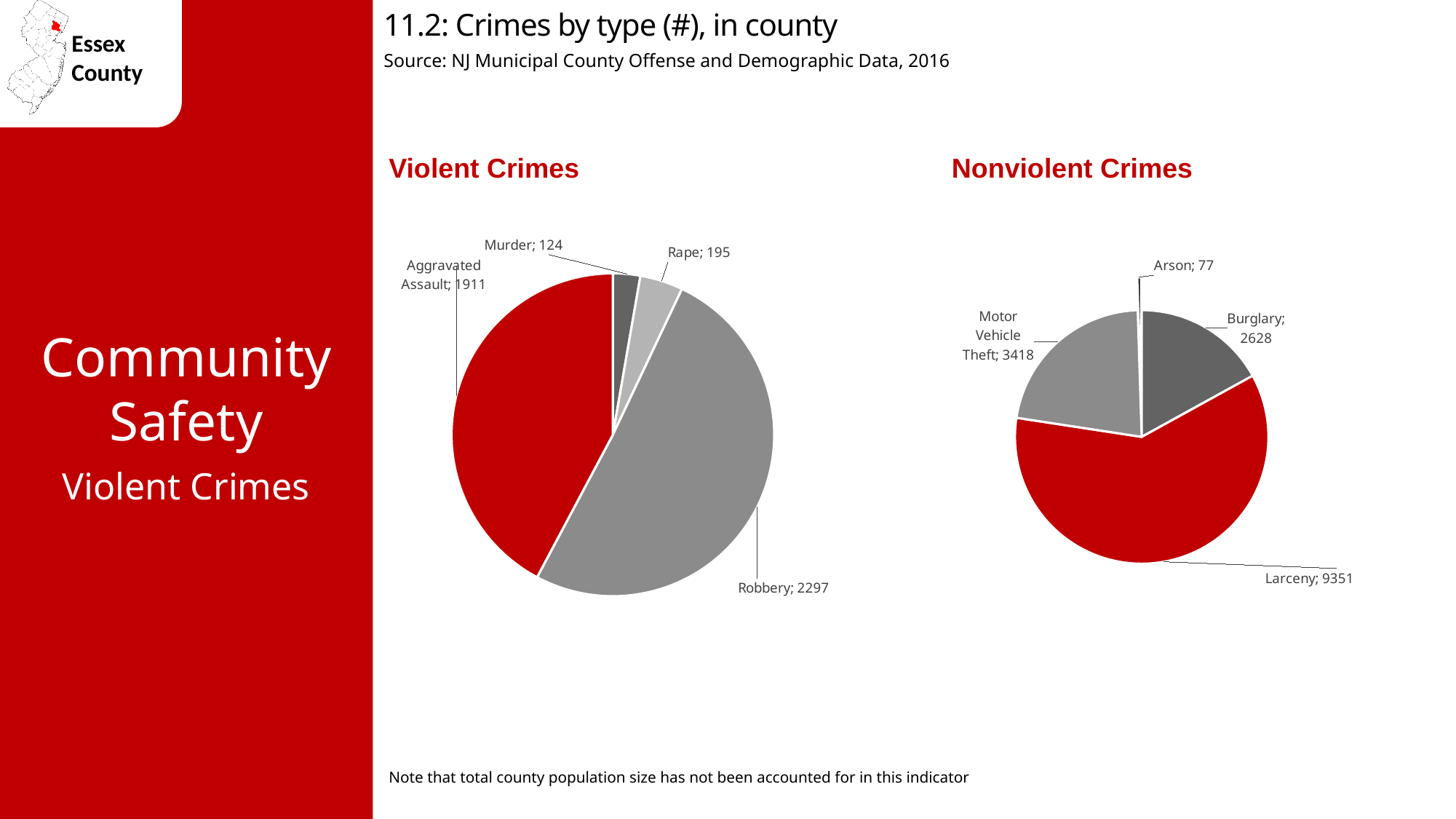
What type of chart is used for Violent Crimes? Pie chart What is the source cited for the charts on this slide? NJ Municipal County Offense and Demographic Data, 2016 In the Nonviolent Crimes pie chart, which crime type has the smallest value? Arson In the Nonviolent Crimes pie chart, which crime type has the largest value? Larceny In the Nonviolent Crimes pie chart, what is the value for Motor Vehicle Theft? 3418 How many crime types are shown in the Nonviolent Crimes pie chart? 4 In the Violent Crimes pie chart, how many robberies are shown? 2297 In the Violent Crimes pie chart, which is larger, Rape or Murder? Rape In the Violent Crimes pie chart, which crime type has the smallest slice? Murder In the Violent Crimes pie chart, which crime type has the largest slice? Robbery In the Violent Crimes pie chart, what is the difference between Robbery and Aggravated Assault? 386 In the Nonviolent Crimes pie chart, what is the difference between Burglary and Arson? 2551